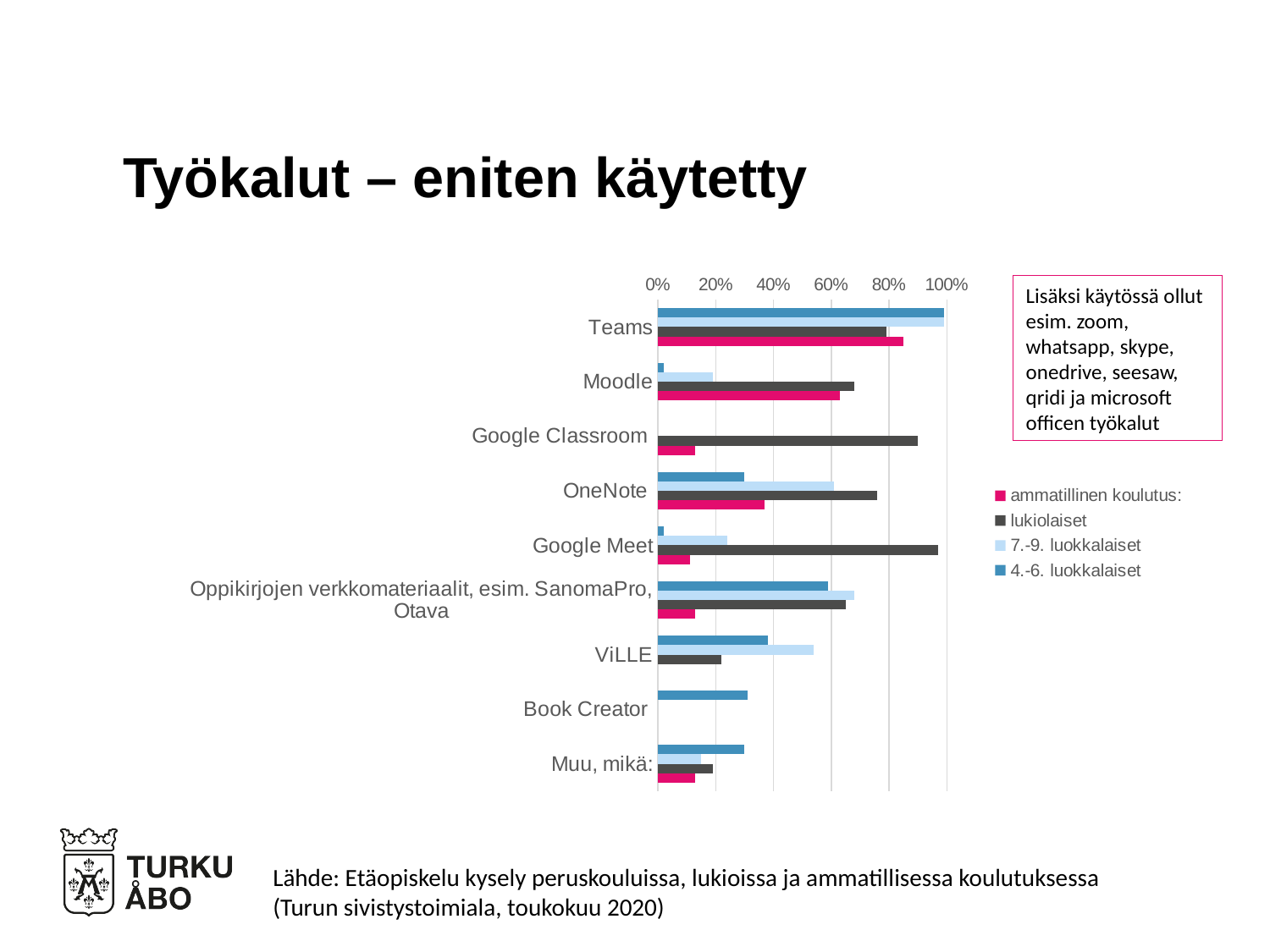
How many series does the chart's legend list? 4 Is the value for Teams among 4.-6. luokkalaiset greater or less than 80%? greater What is the title of the slide containing the chart? Työkalut – eniten käytetty Is the value for Book Creator among 4.-6. luokkalaiset greater or less than 20%? greater Is the value for Google Classroom among lukiolaiset greater or less than 80%? greater For Moodle, which series has the larger value: lukiolaiset or 7.-9. luokkalaiset? lukiolaiset How many tool categories are listed on the chart's vertical axis? 9 For Google Classroom, which series has the larger value: lukiolaiset or ammatillinen koulutus? lukiolaiset What kind of chart is shown on the slide? bar chart Which tool has the highest value for ammatillinen koulutus? Teams